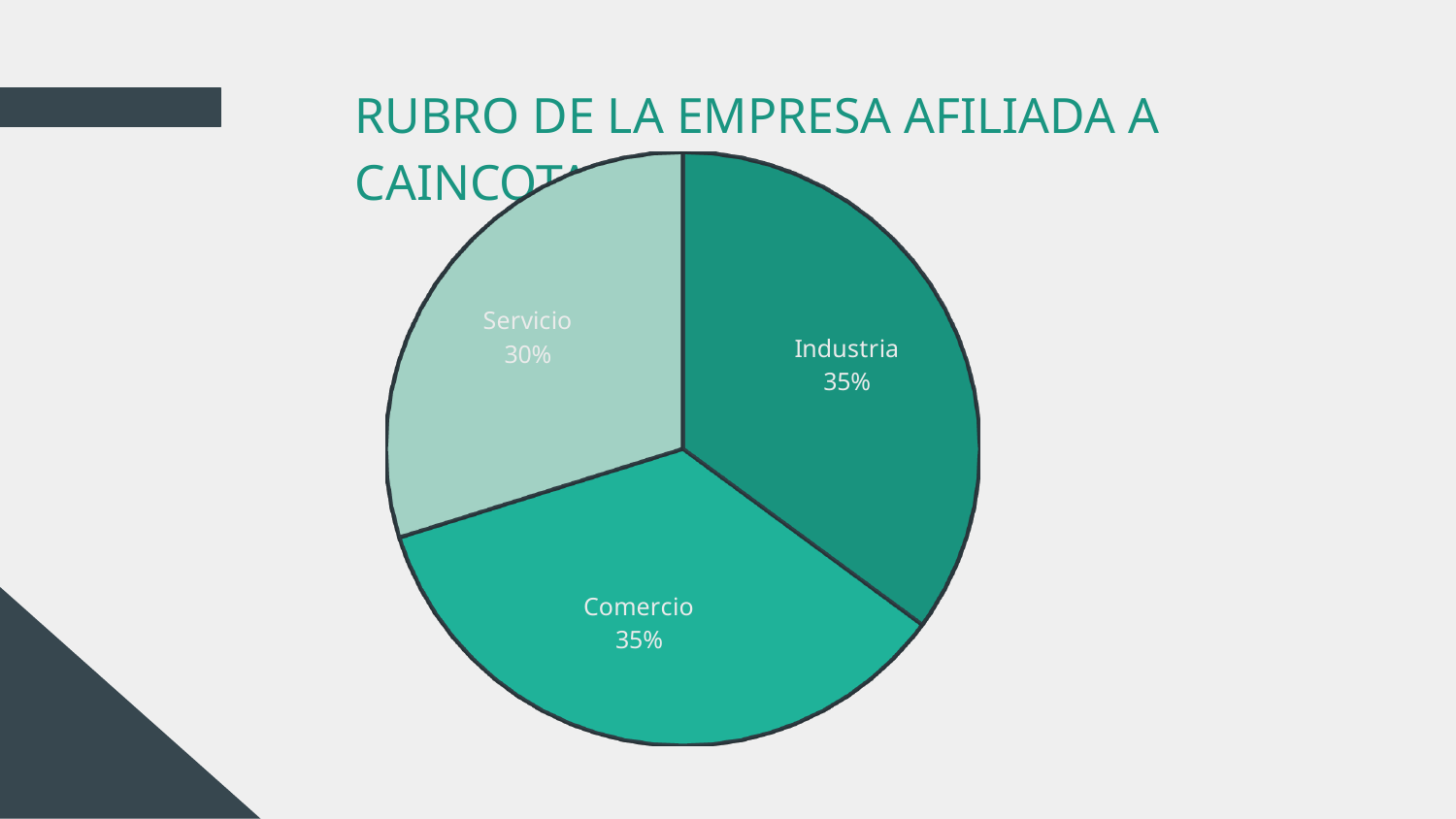
Which category's label appears on the right-hand slice of the pie? Industria Which slice of the pie is the lightest in colour? Servicio What kind of chart is shown on the slide? pie chart What percentage of the pie does the Servicio slice represent? 30% How many slices does the pie chart have? 3 What is the difference in percentage points between the Industria share and the Servicio share? 5 Which category has the smallest share of the pie? Servicio Which is larger, the share for Comercio or the share for Servicio? Comercio What percentage of the pie does the Industria slice represent? 35% Which is larger, the share for Industria or the share for Servicio? Industria Do the Industria and Comercio slices have the same share of the pie? Yes What percentage of the pie does the Comercio slice represent? 35%